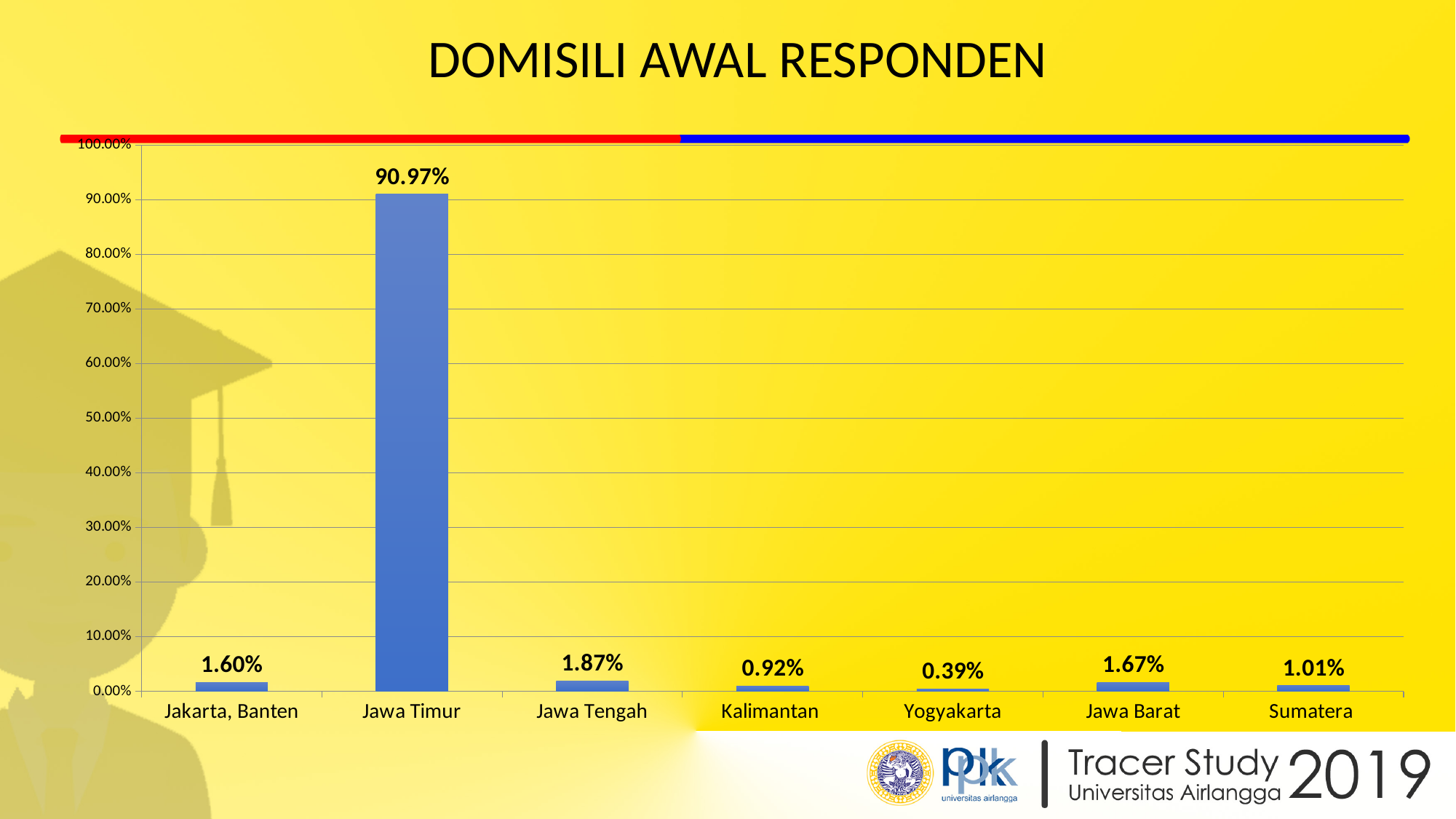
What is the value for Sumatera? 1.01% What is the value for Jawa Timur? 90.97% What is the title of the chart? DOMISILI AWAL RESPONDEN How many categories are shown on the x axis? 7 Is the value for Jawa Timur greater or less than 80.00%? greater What is the difference between the values for Jawa Tengah and Kalimantan? 0.95% What is the value for Yogyakarta? 0.39% What is the value for Jakarta, Banten? 1.60% What kind of chart is shown on the slide? bar chart Which category has the lowest value? Yogyakarta Which category has the highest value? Jawa Timur Which is larger, the value for Jawa Barat or the value for Sumatera? Jawa Barat